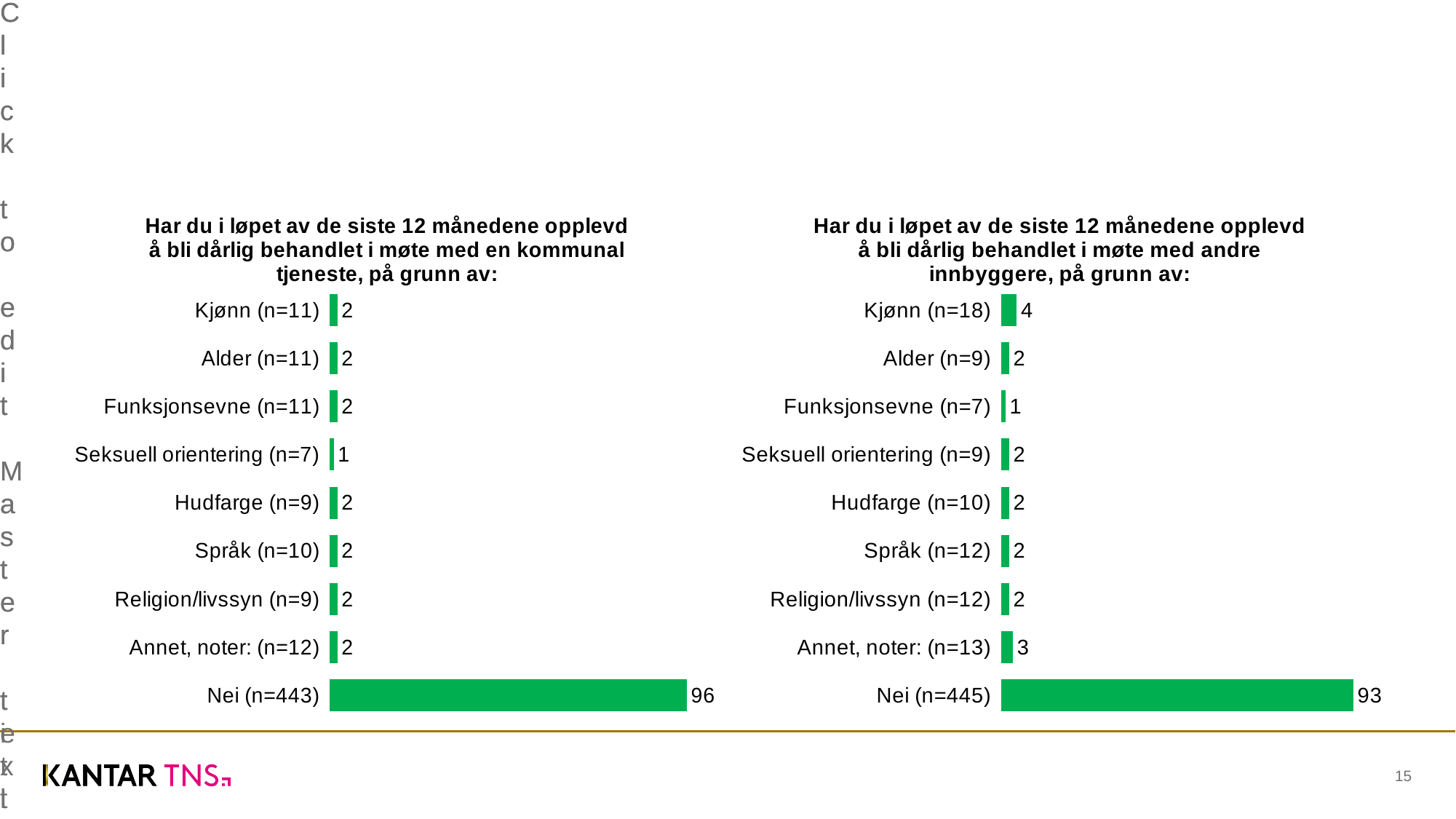
In the right chart (andre innbyggere), what is the value for Annet, noter: (n=13)? 3 How many categories are shown in the left chart (kommunal tjeneste)? 9 In the right chart (andre innbyggere), what is the value for Kjønn (n=18)? 4 What is the difference between the Nei value in the left chart (96) and the Nei value in the right chart (93)? 3 In the left chart (kommunal tjeneste), what is the value for Seksuell orientering (n=7)? 1 In the right chart (andre innbyggere), which category has the lowest value? Funksjonsevne (n=7) In the left chart (kommunal tjeneste), which category has the lowest value? Seksuell orientering (n=7) What type of chart is used on this slide? Bar chart In the right chart (andre innbyggere), what is the difference between Kjønn (n=18) and Funksjonsevne (n=7)? 3 In the right chart (andre innbyggere), which category has the highest value? Nei (n=445) Which is larger: the value for Kjønn in the left chart or the value for Kjønn in the right chart? Right chart (Kjønn, 4) In the left chart (kommunal tjeneste), what is the value for Nei (n=443)? 96